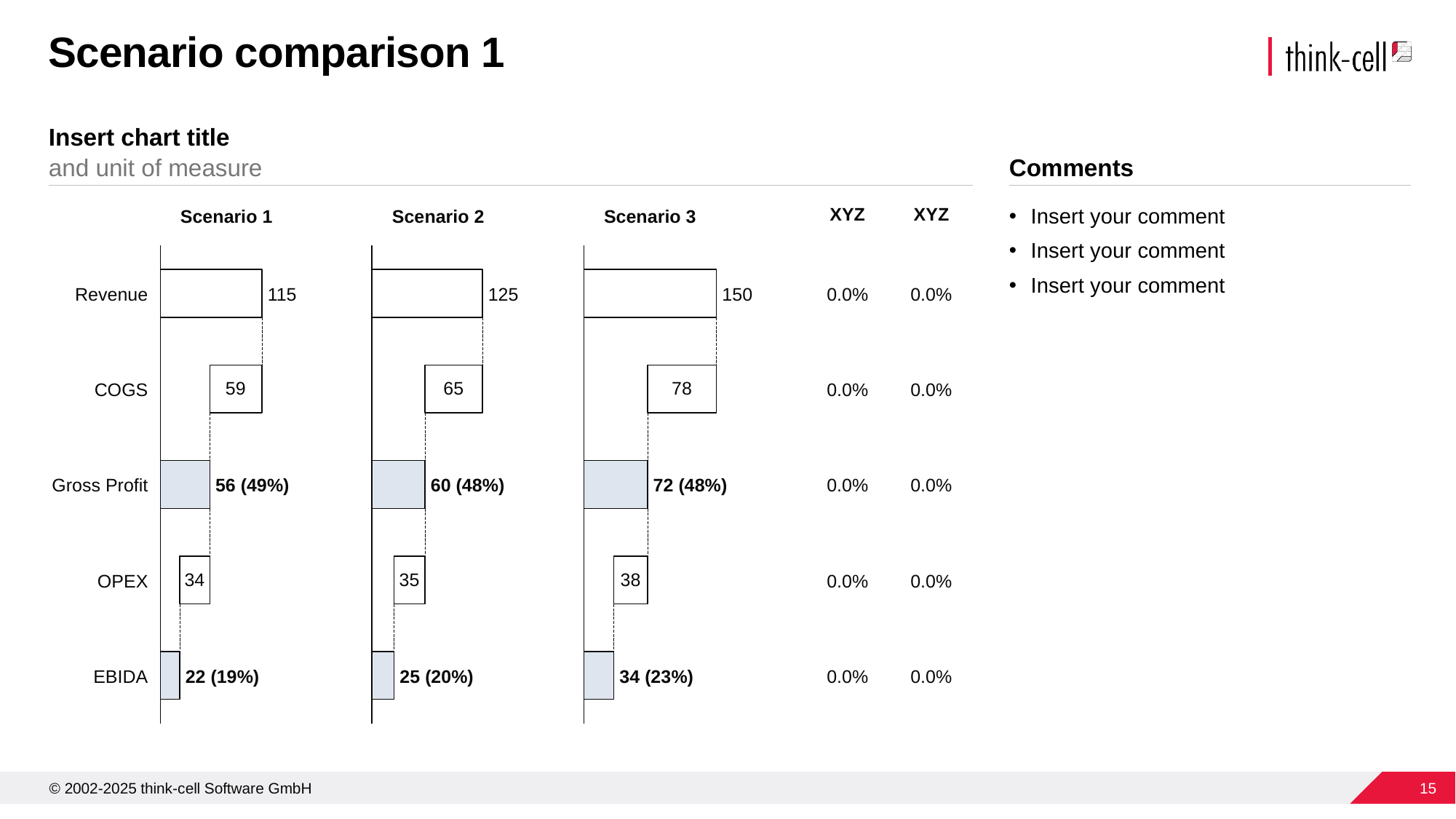
In the Scenario 2 chart, what is the label shown for EBIDA? 25 (20%) Which scenario chart shows the lowest EBIDA? Scenario 1 How many scenario charts are shown on the slide? 3 How many categories are shown in the Scenario 1 chart? 5 In the Scenario 2 chart, what is the value for COGS? 65 In the Scenario 3 chart, what is the label shown for Gross Profit? 72 (48%) In the Scenario 3 chart, what is the value for OPEX? 38 Is COGS larger in the Scenario 2 chart or the Scenario 3 chart? Scenario 3 What is the difference between Revenue in the Scenario 3 chart and Revenue in the Scenario 1 chart? 35 Which scenario chart shows the highest Revenue? Scenario 3 In the Scenario 1 chart, what is the difference between Revenue and COGS? 56 In the Scenario 1 chart, what is the value for Revenue? 115